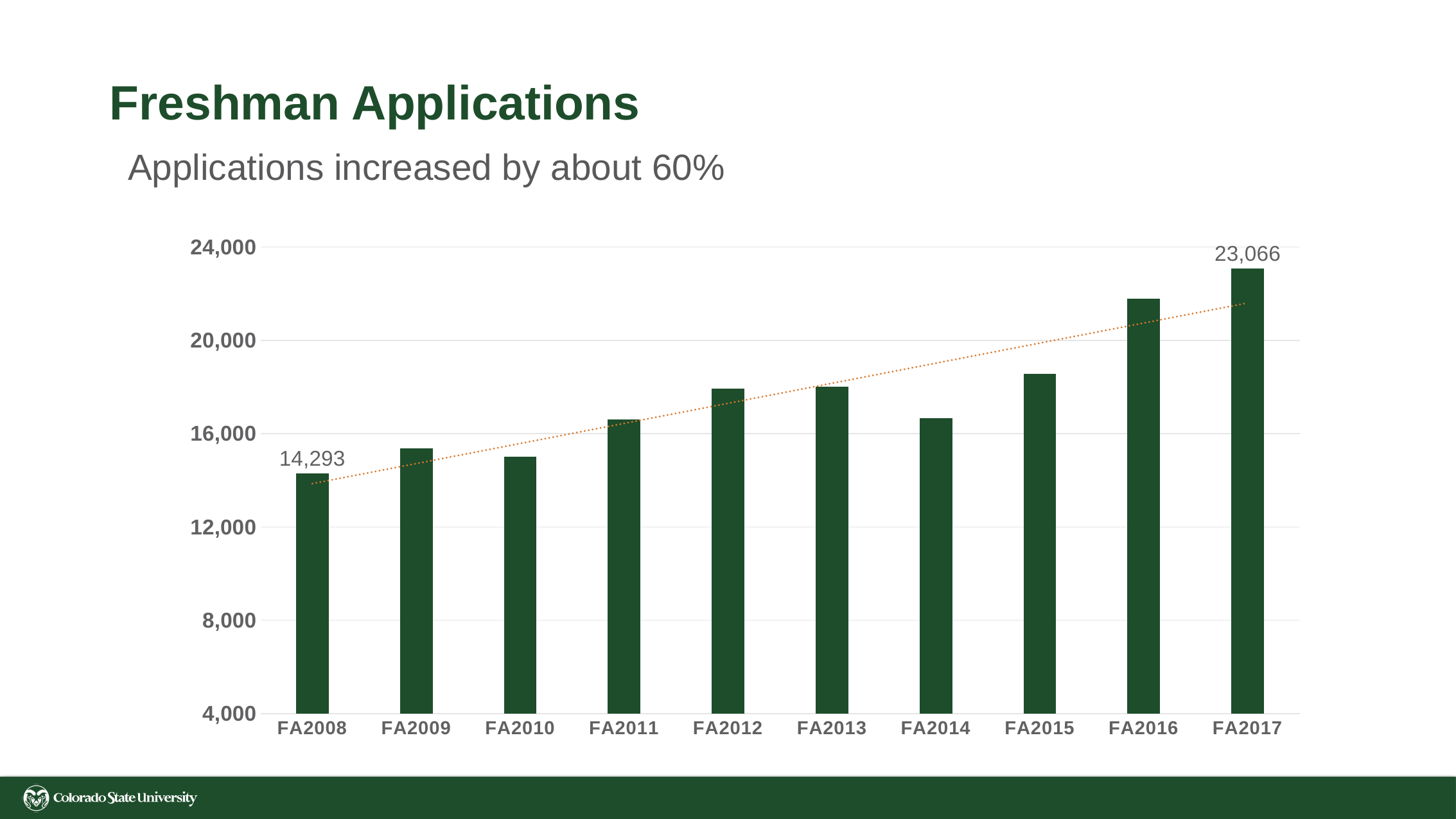
Is the value for FA2014 greater or less than 20,000? less Which is larger, the value for FA2016 or the value for FA2015? FA2016 What is the value for FA2017? 23,066 Which year has the lowest number of freshman applications? FA2008 What is the title of the slide? Freshman Applications What is the value for FA2008? 14,293 Which year has the highest number of freshman applications? FA2017 Is the value for FA2016 greater or less than 20,000? greater What is the difference between the FA2017 and FA2008 values? 8,773 Is the value for FA2010 greater or less than 16,000? less How many years are shown on the x axis? 10 What kind of chart is shown on the slide? bar chart